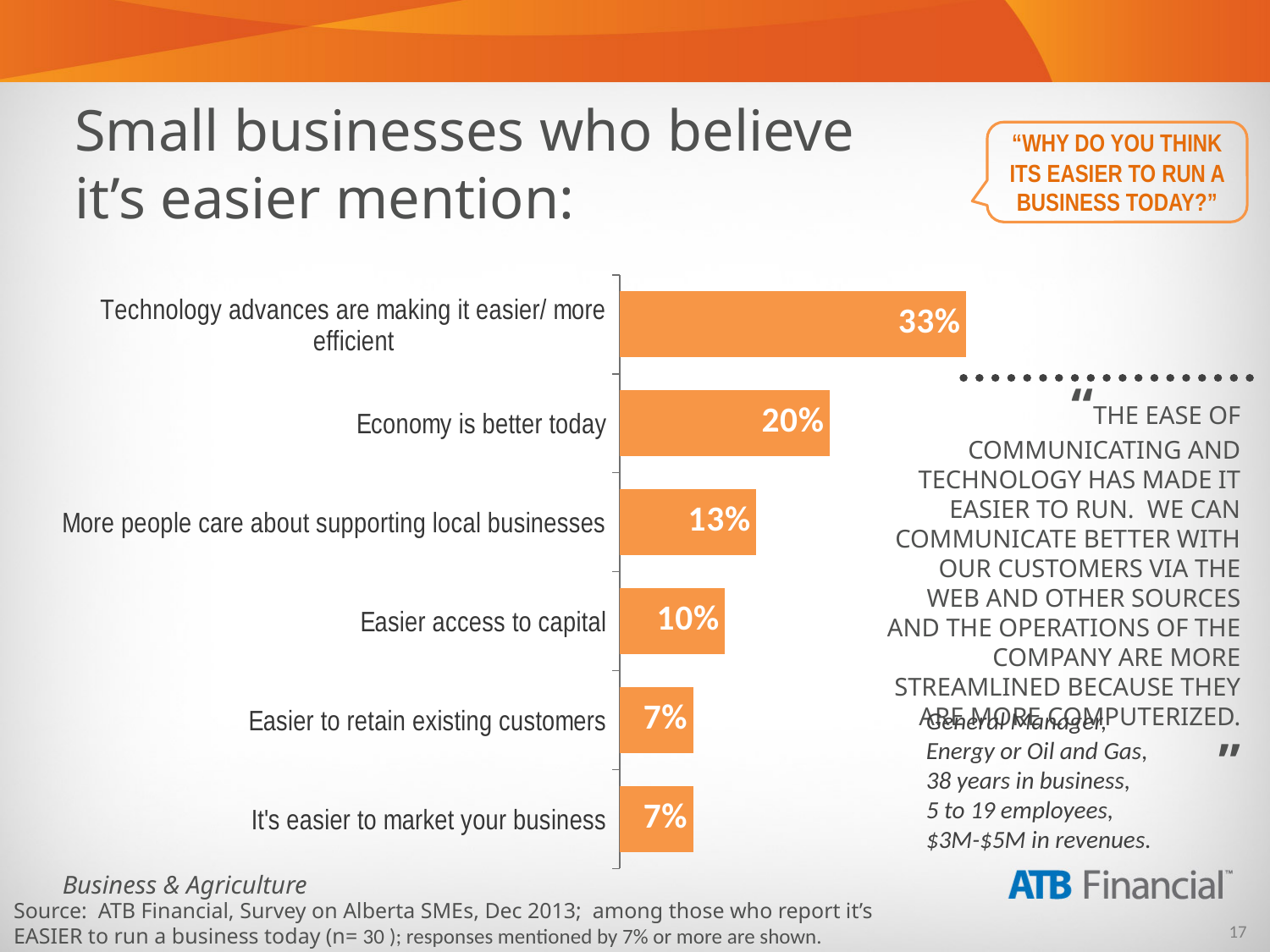
Which reason has the highest percentage? Technology advances are making it easier/ more efficient What is the difference between 'More people care about supporting local businesses' and 'Easier to retain existing customers'? 6% Which two reasons share the same value of 7%? Easier to retain existing customers; It's easier to market your business What percentage of small businesses mention that technology advances are making it easier/more efficient? 33% What percentage mention 'Easier access to capital'? 10% How many reasons (categories) are shown in the chart? 6 What colour are the bars in the chart? Orange What kind of chart is shown on the slide? Bar chart Which is larger: the value for 'Economy is better today' or 'Easier access to capital'? Economy is better today What is the value for 'More people care about supporting local businesses'? 13% What is the value for 'Economy is better today'? 20% What is the difference between the percentage for 'Technology advances are making it easier/ more efficient' and 'Economy is better today'? 13%